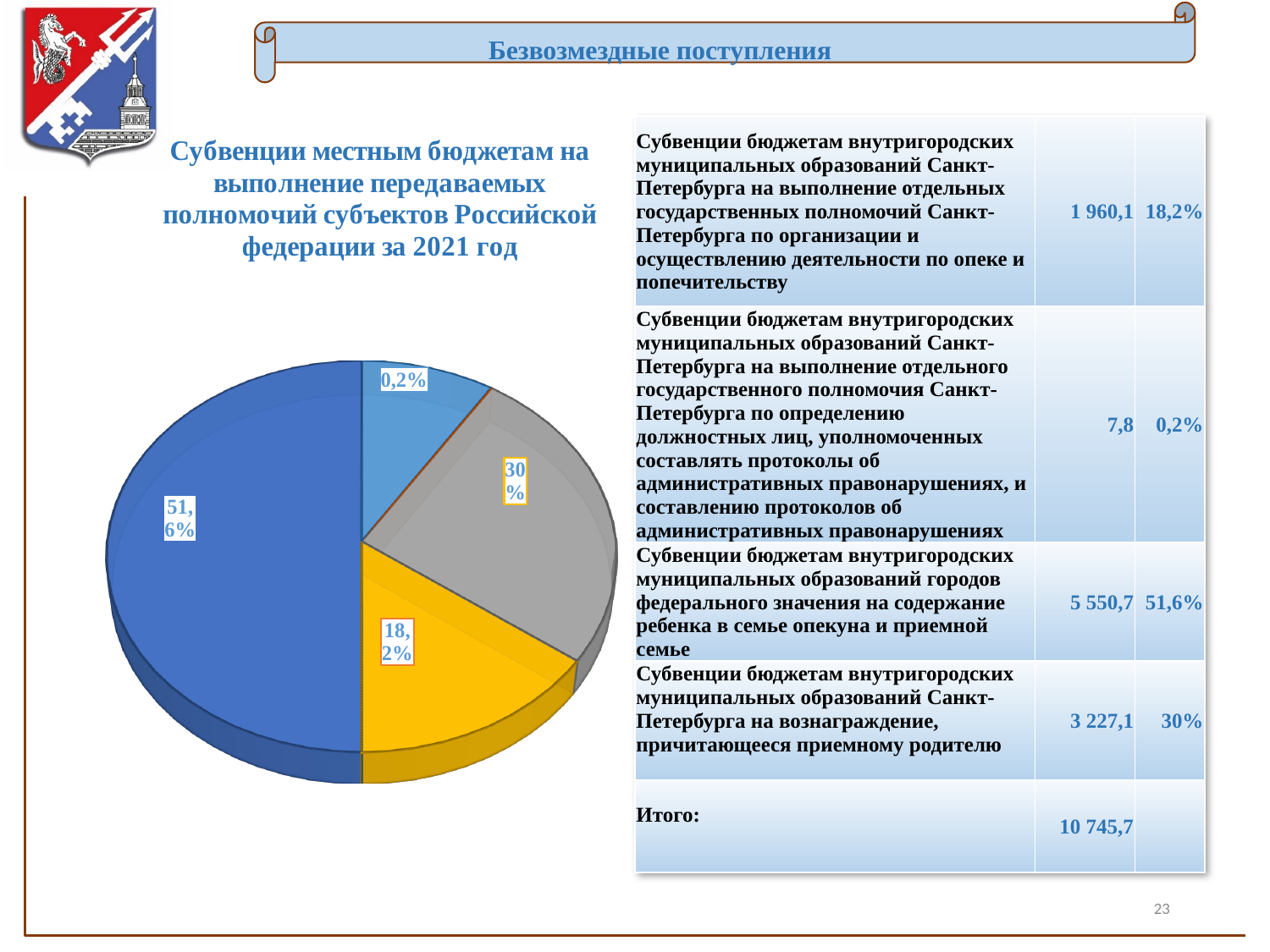
What is the share of the largest slice in the pie chart? 51,6% What share of the pie is labelled for the grey slice? 30% According to the table, which share of the pie corresponds to subventions for the maintenance of a child in a guardian's or foster family (содержание ребенка в семье опекуна и приемной семье)? 51,6% What kind of chart is shown on the slide? pie chart What is the title of the pie chart? Субвенции местным бюджетам на выполнение передаваемых полномочий субъектов Российской федерации за 2021 год According to the table, what share of the pie corresponds to subventions for remuneration of a foster parent (вознаграждение, причитающееся приемному родителю)? 30% By how many percentage points does the 51,6% slice exceed the 30% slice? 21,6 Which slice is larger: the one labelled 30% or the one labelled 18,2%? 30% What share of the pie is labelled for the yellow slice? 18,2% What is the share of the smallest slice in the pie chart? 0,2% How many slices does the pie chart have? 4 What colour is the largest slice of the pie chart? blue